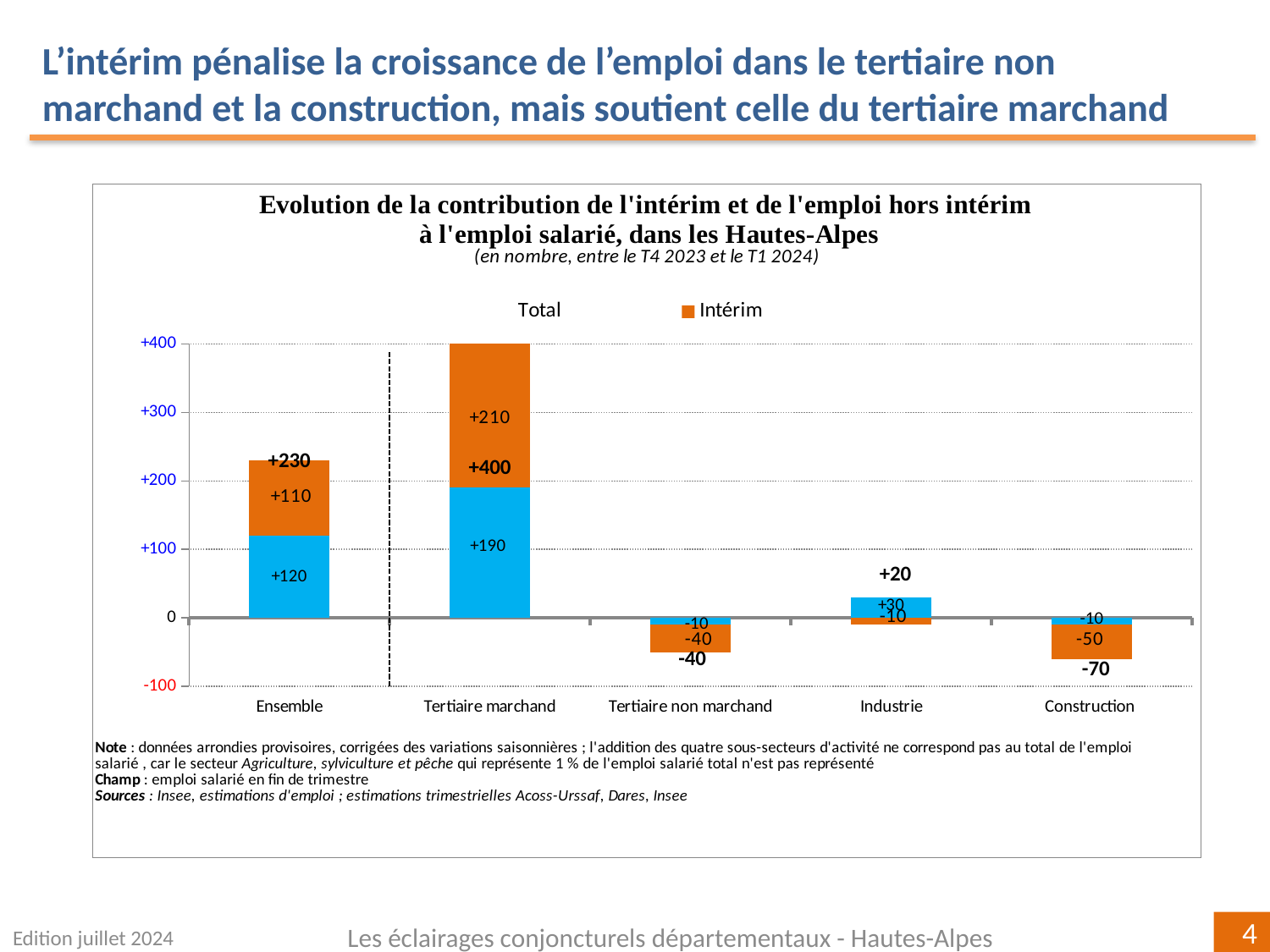
How many entries does the legend list? 2 How many categories are shown on the x axis? 5 What is the total (bold label) for Tertiaire marchand? +400 Is the Intérim value for Tertiaire marchand larger or smaller than the Intérim value for Ensemble? larger What is the difference between the Intérim value for Tertiaire marchand (+210) and the Intérim value for Ensemble (+110)? 100 What is the Intérim (orange) value for Tertiaire non marchand? -40 What kind of chart is this? Stacked bar chart Which category has the lowest total? Construction What is the Intérim (orange) value for Ensemble? +110 Which category has the highest total? Tertiaire marchand What is the blue (hors intérim) value for Industrie? +30 What is the total (bold label) for Construction? -70